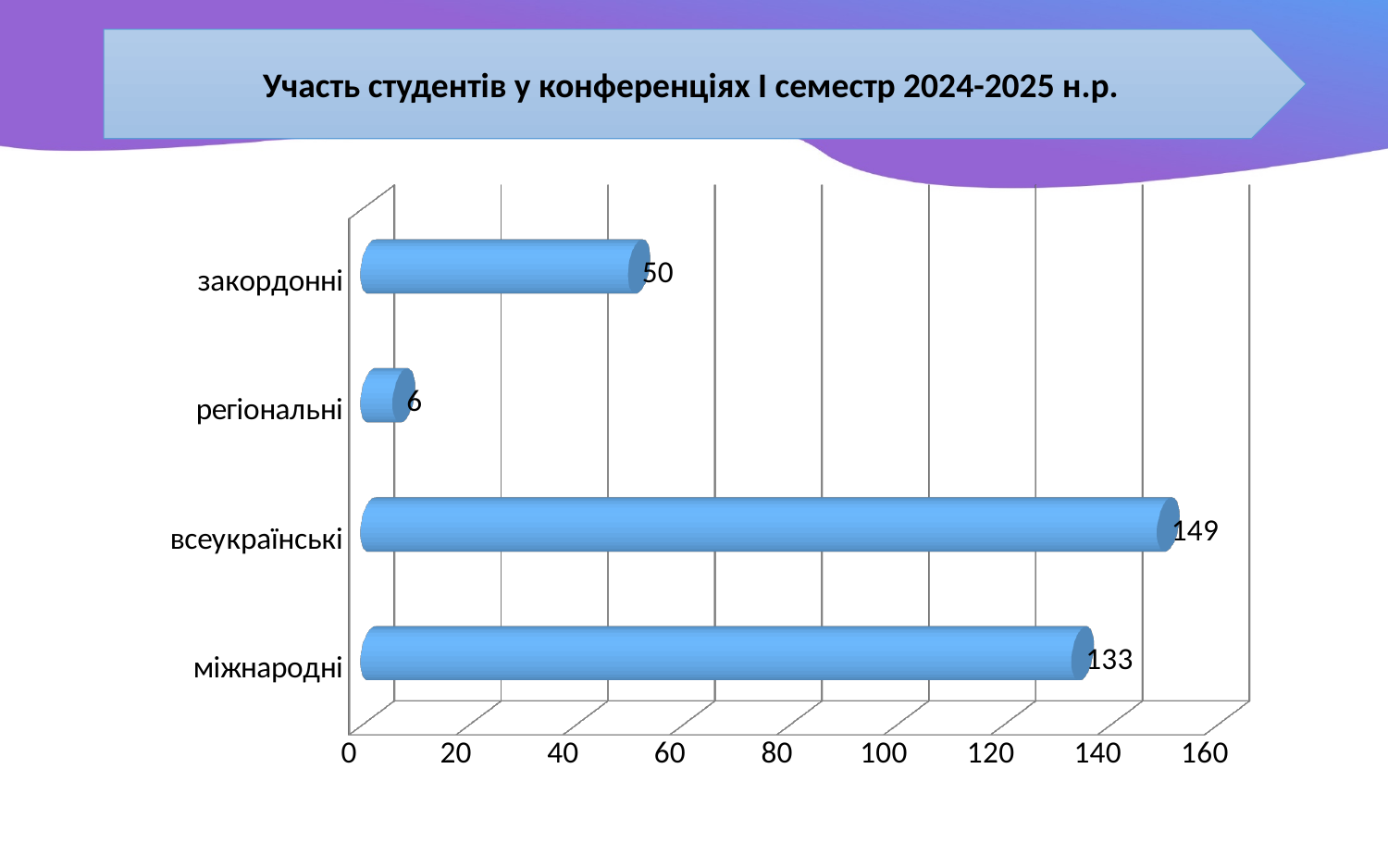
What is the value for регіональні? 6 What is the difference between the values for всеукраїнські and міжнародні? 16 What is the value for міжнародні? 133 Which category has the lowest value? регіональні Which category has the highest value? всеукраїнські Which is larger, the value for закордонні or the value for регіональні? закордонні What is the title shown above the chart? Участь студентів у конференціях І семестр 2024-2025 н.р. What is the value for закордонні? 50 Is the value for міжнародні greater or less than 120? greater How many categories are shown in the chart? 4 What is the value for всеукраїнські? 149 What kind of chart is shown on the slide? bar chart